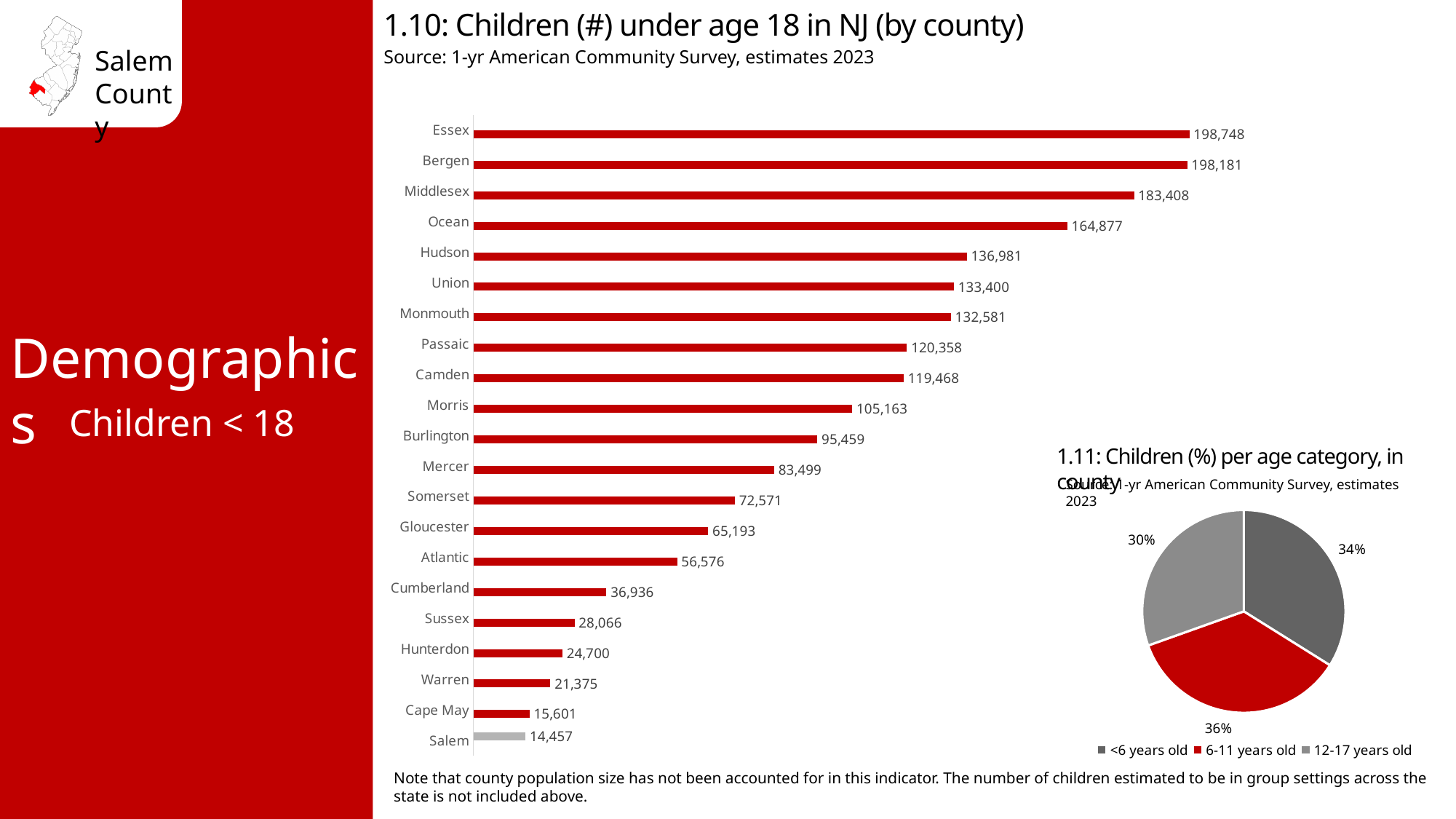
In chart 1.11, what colour is the slice for 6-11 years old? Red In chart 1.10, how many counties are shown? 21 In chart 1.10, how many children under age 18 are in Salem County? 14,457 In chart 1.10, which county has the lowest number of children under 18? Salem In chart 1.10, what is the value for Gloucester? 65,193 In chart 1.10, which county has more children under 18, Cumberland or Sussex? Cumberland In chart 1.10, which county has the highest number of children under 18? Essex In chart 1.11, what percentage of children in Salem County are 6-11 years old? 36% In chart 1.10, what is the difference between the values for Gloucester and Atlantic? 8,617 What type of chart is chart 1.10? Bar chart How many categories does the legend of chart 1.11 list? 3 In chart 1.11, which age category has the smallest share? 12-17 years old